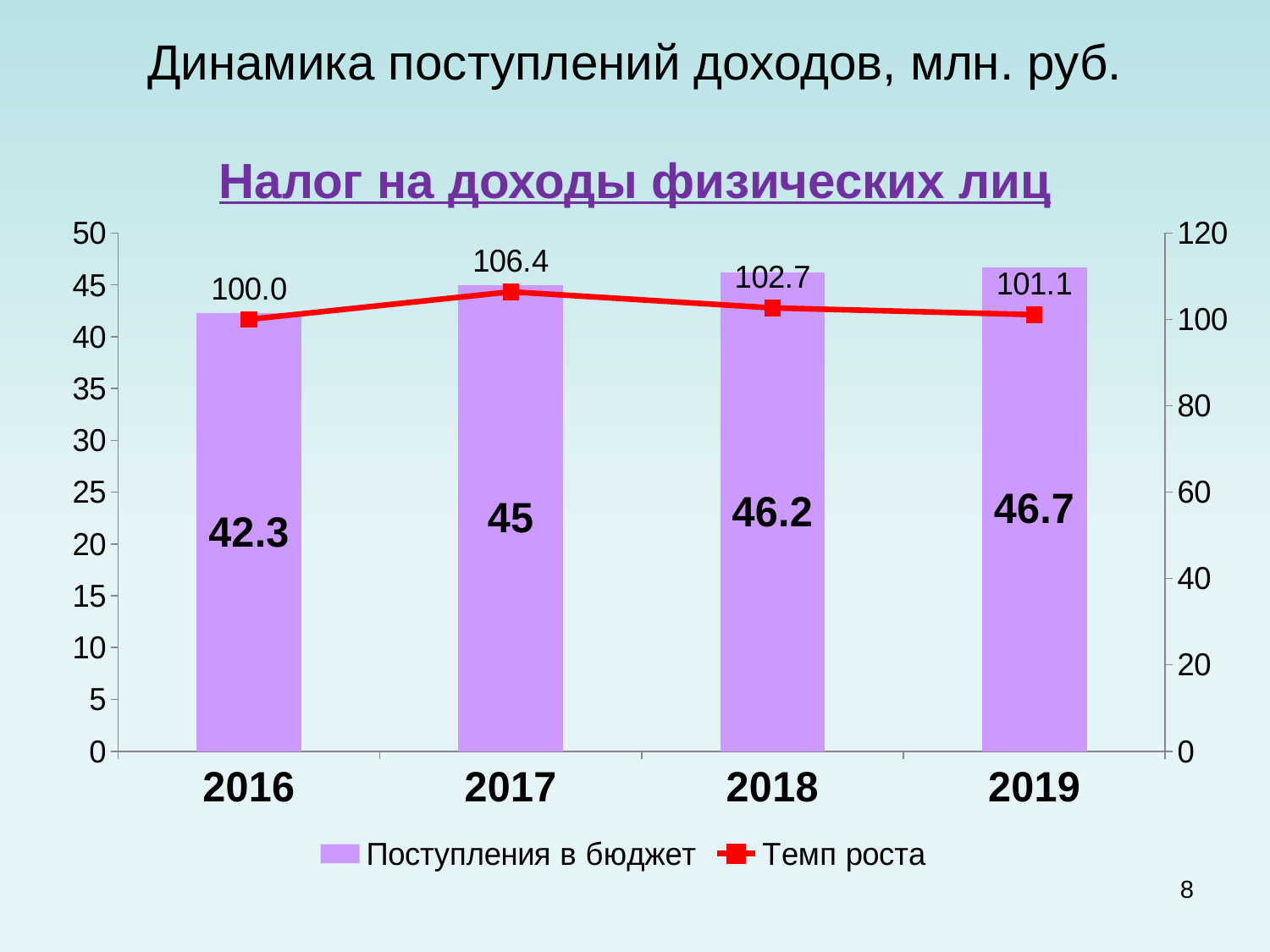
Which year has the higher Темп роста value, 2017 or 2019? 2017 What kind of chart is used for the Поступления в бюджет series? bar chart What is the Темп роста value for 2018? 102.7 Which year has the lowest Темп роста value? 2016 What is the difference between the Поступления в бюджет values for 2019 and 2016? 4.4 How many series does the legend list? 2 What is the value of Поступления в бюджет for 2017? 45 What is the title of the chart? Налог на доходы физических лиц How many years are shown on the x axis? 4 Do the Поступления в бюджет values rise or fall from 2016 to 2019? rise Is the Поступления в бюджет value for 2016 greater or less than 40? greater Which year has the highest Поступления в бюджет value? 2019